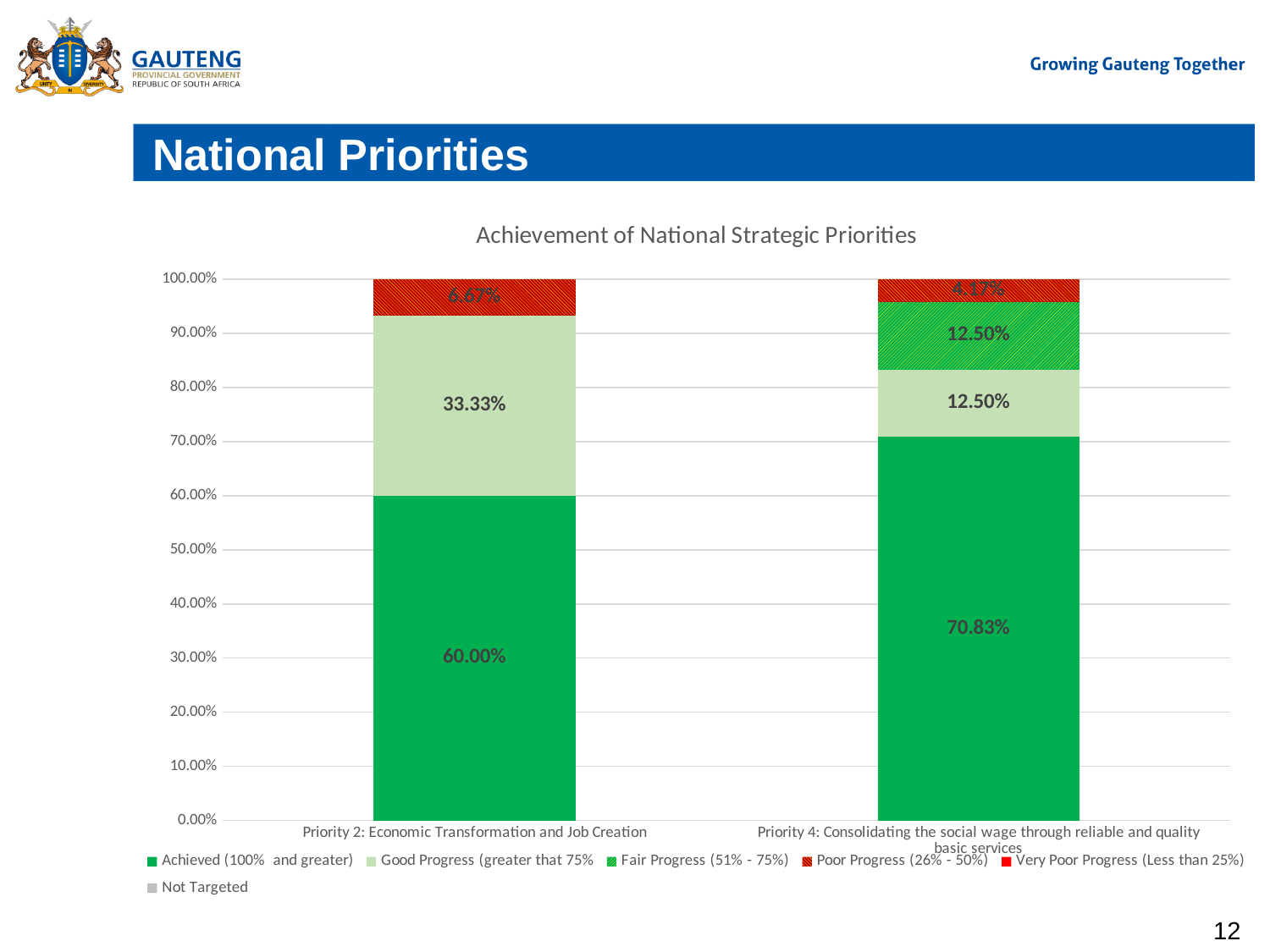
What is the title of the chart? Achievement of National Strategic Priorities Which priority has the larger Achieved (100% and greater) share, Priority 2 or Priority 4? Priority 4 What is the Good Progress (greater that 75%) value for Priority 2? 33.33% What kind of chart is shown on the slide? Stacked bar chart What is the Fair Progress (51% - 75%) value for Priority 4? 12.50% How many priorities (categories) are plotted on the x axis? 2 What is the difference between the Achieved values for Priority 4 and Priority 2? 10.83% What is the difference between the Good Progress values for Priority 2 and Priority 4? 20.83% What is the Achieved (100% and greater) value for Priority 2: Economic Transformation and Job Creation? 60.00% What is the Achieved (100% and greater) value for Priority 4: Consolidating the social wage through reliable and quality basic services? 70.83% How many series does the legend list? 6 What value is shown on the red top segment of the Priority 2 bar? 6.67%